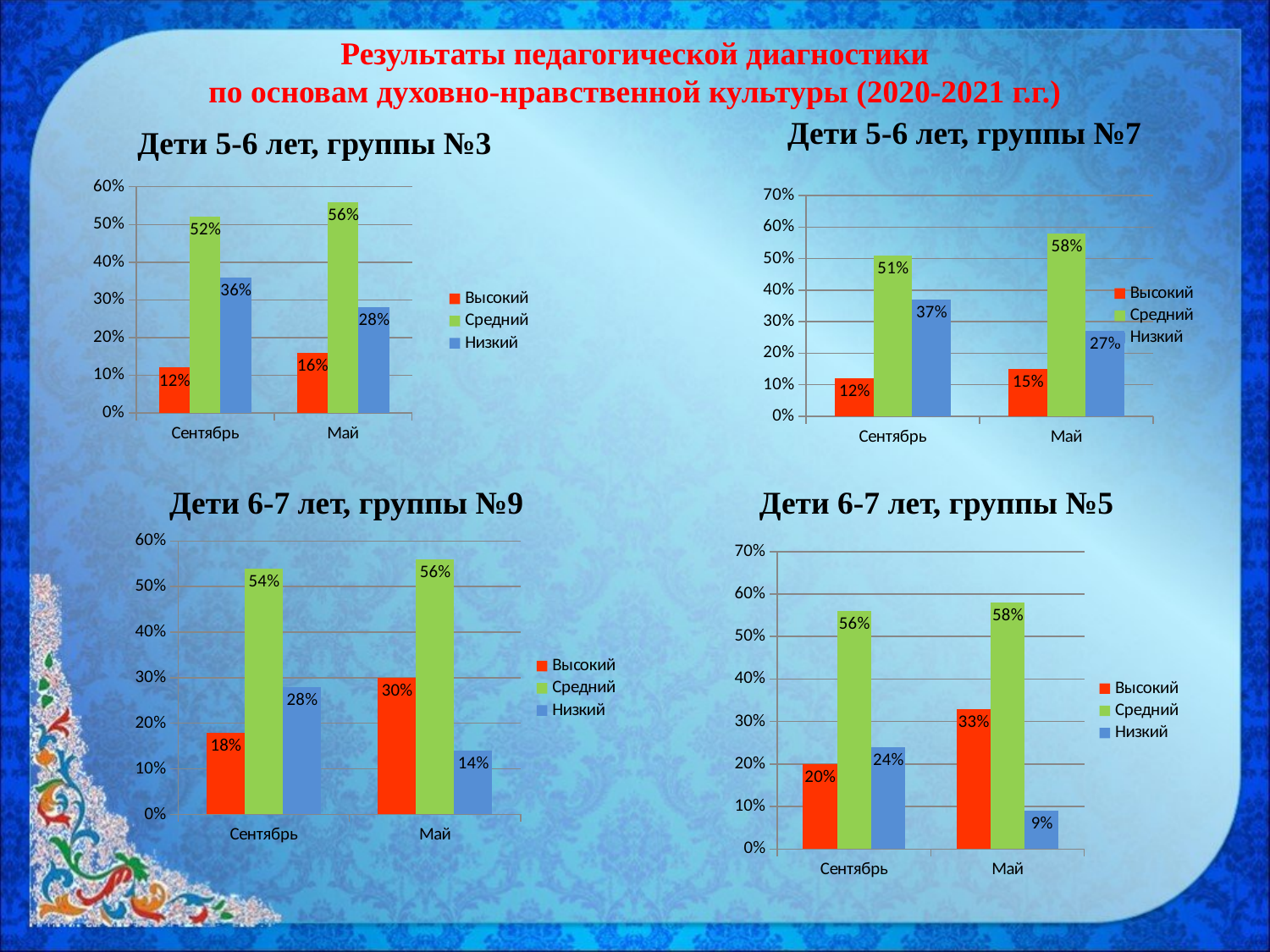
In the chart 'Дети 5-6 лет, группы №7', what is the value for Высокий in Май? 15% What kind of chart is 'Дети 6-7 лет, группы №5'? bar chart In the chart 'Дети 6-7 лет, группы №5', is the value for Высокий in Сентябрь or in Май larger? Май In the chart 'Дети 5-6 лет, группы №3', what is the value for Средний in Май? 56% In the chart 'Дети 6-7 лет, группы №5', what is the value for Низкий in Май? 9% In the chart 'Дети 5-6 лет, группы №7', what is the difference between Низкий in Сентябрь and Низкий in Май? 10% In the chart 'Дети 6-7 лет, группы №9', what is the value for Высокий in Сентябрь? 18% In the chart 'Дети 6-7 лет, группы №9', which series has the highest value in Май? Средний How many series does the legend list in the chart 'Дети 5-6 лет, группы №7'? 3 In the chart 'Дети 6-7 лет, группы №5', which series has the lowest value in Май? Низкий In the chart 'Дети 6-7 лет, группы №9', does the value for Низкий rise or fall from Сентябрь to Май? fall In the chart 'Дети 5-6 лет, группы №3', what is the value for Низкий in Сентябрь? 36%